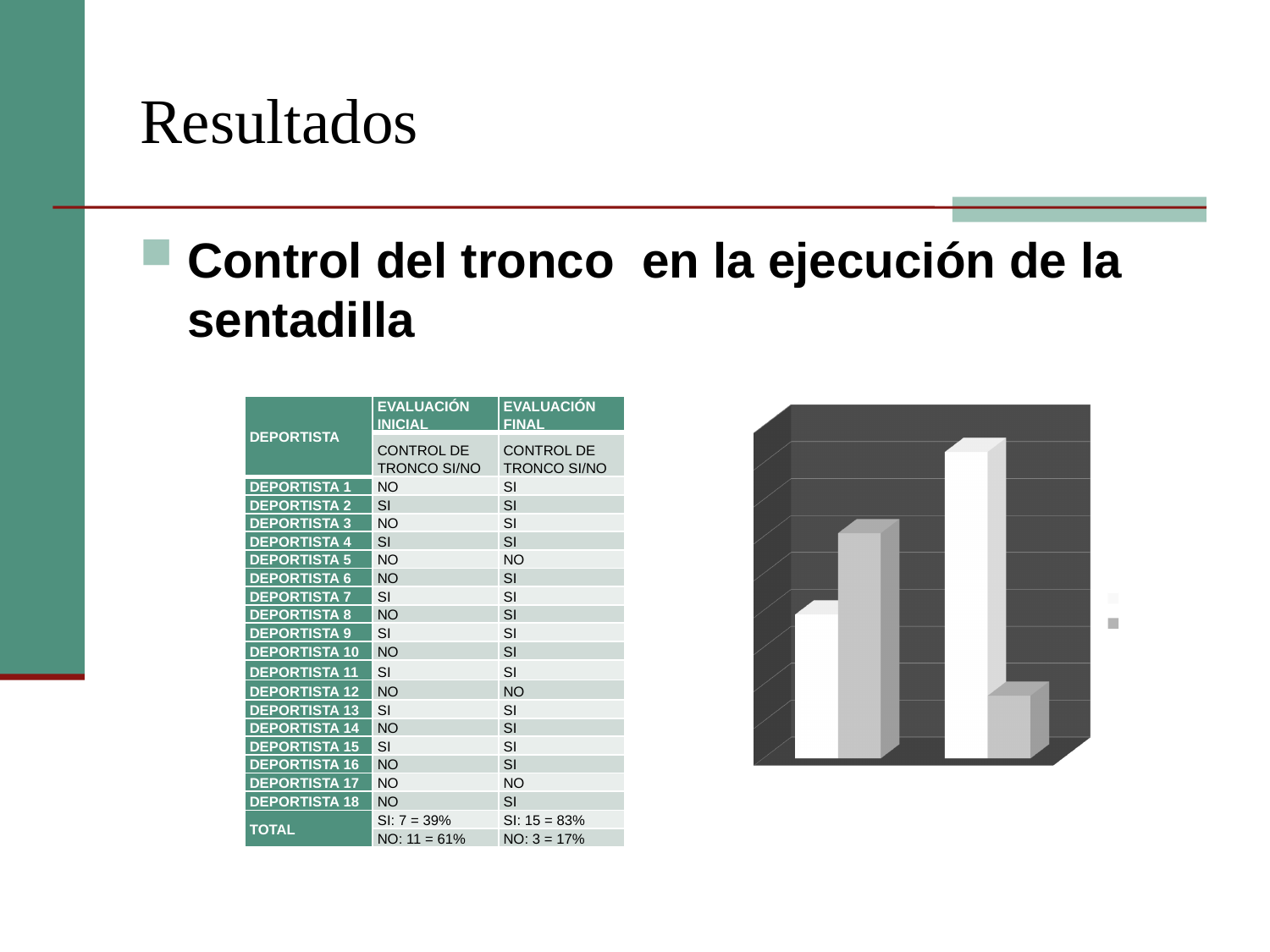
What kind of chart is shown on the right side of the slide? bar chart In the chart on the right side of the slide, which bar is taller in the left group: the white bar or the grey bar? the grey bar How many groups of bars does the chart on the right side of the slide contain? 2 How many bars are plotted in the chart on the right side of the slide? 4 How many entries does the legend of the chart on the right side of the slide show? 2 In the chart on the right side of the slide, is the tallest bar in the left group or the right group of bars? right group In the chart on the right side of the slide, is the shortest bar in the left group or the right group of bars? right group In the chart on the right side of the slide, which bar is taller in the right group: the white bar or the grey bar? the white bar